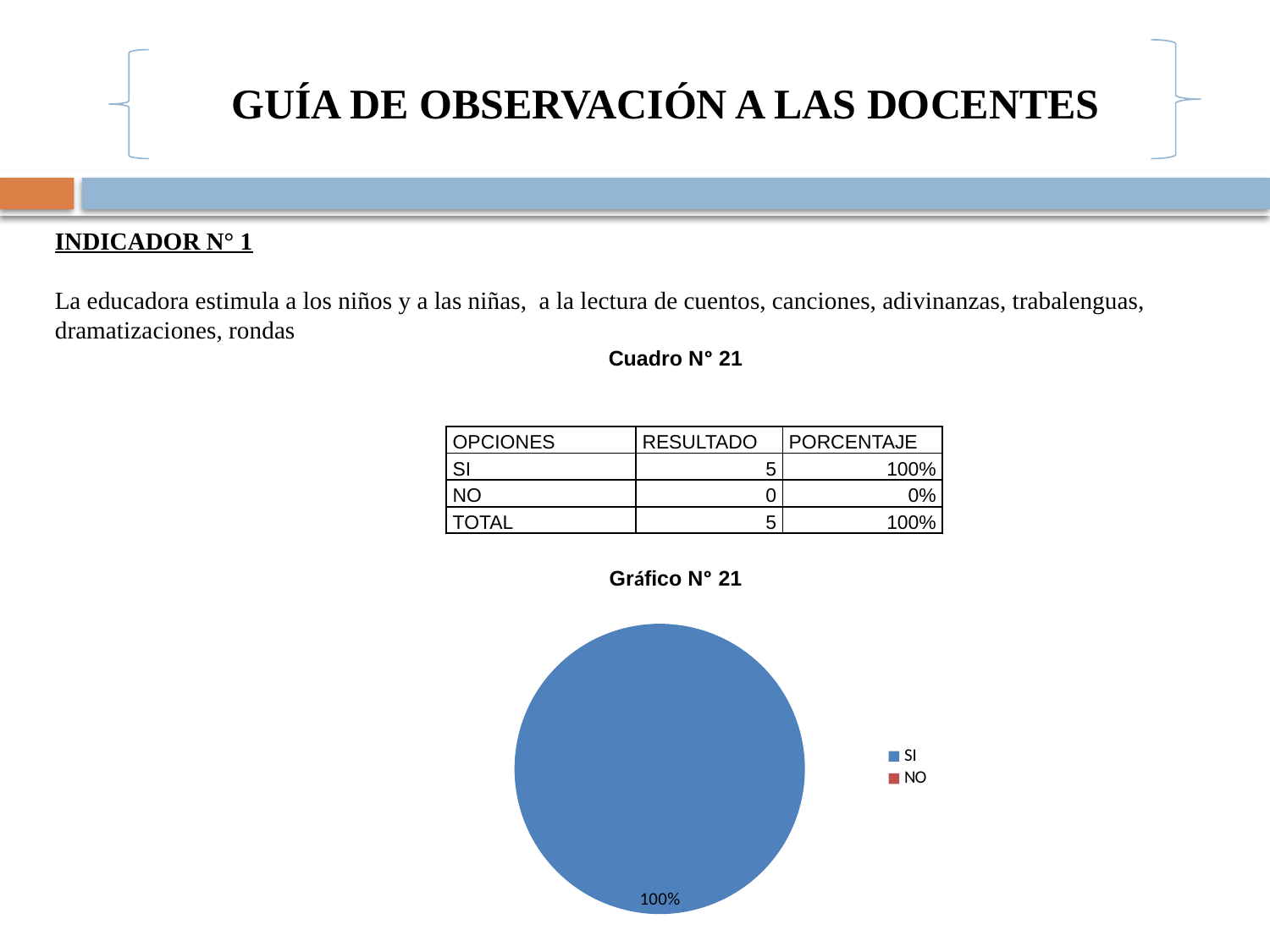
How many series does the legend of Gráfico N° 21 list? 2 Which category is smallest in Gráfico N° 21? NO Which category is largest in Gráfico N° 21? SI What colour is the SI slice in Gráfico N° 21? blue What data label is printed on the pie in Gráfico N° 21? 100% What share of the pie in Gráfico N° 21 does NO take? 0% In Gráfico N° 21, which is larger, SI or NO? SI What is the difference in percentage between SI and NO in Gráfico N° 21? 100% What kind of chart is Gráfico N° 21? pie chart What share of the pie in Gráfico N° 21 does SI take? 100% What is the title of the chart on the slide? Gráfico N° 21